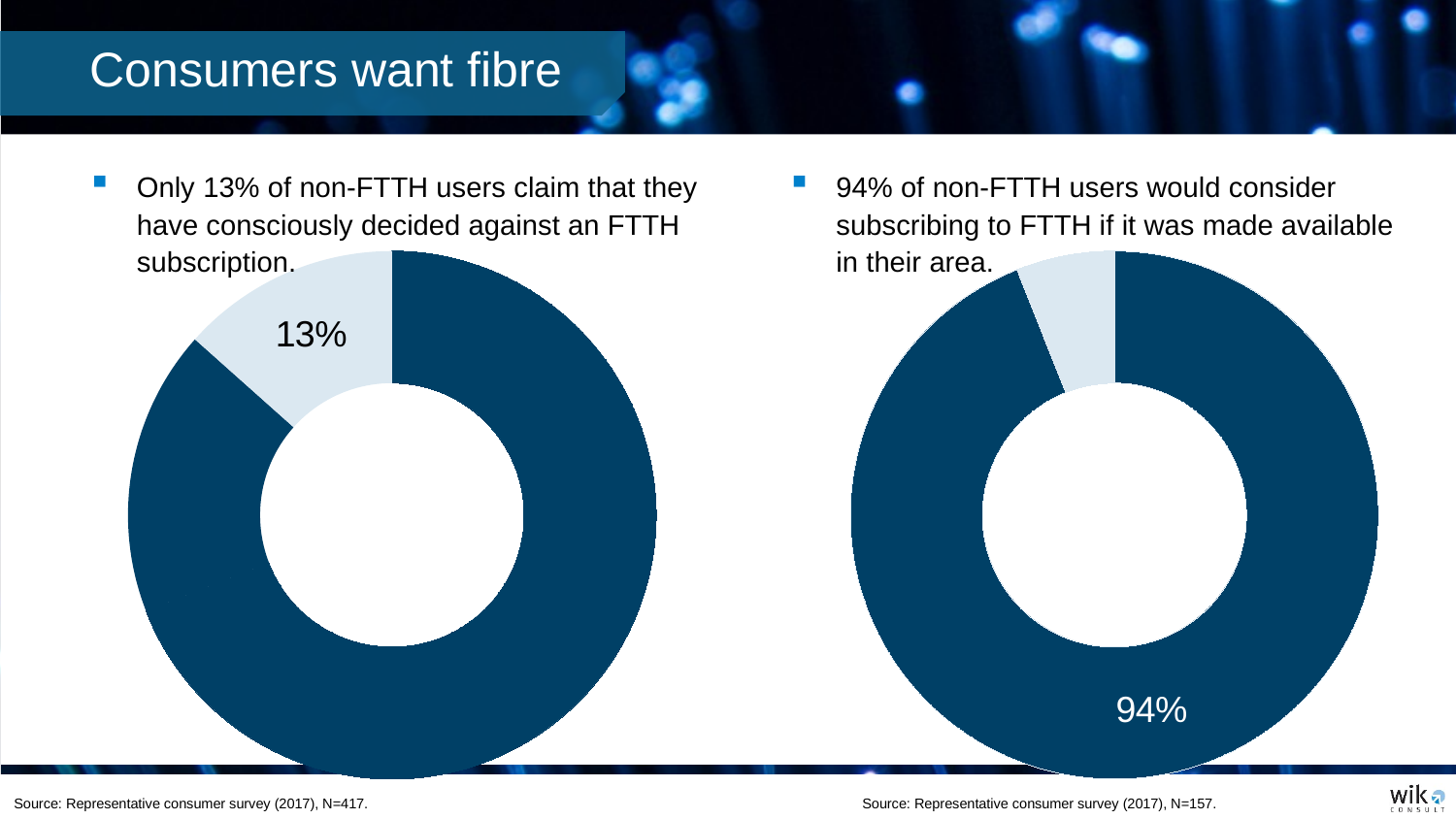
In the right chart, which slice is smaller, the dark one or the light one? The light one How many slices does the right donut chart have? 2 In the left chart, which slice is larger, the dark one or the light one? The dark one What kind of chart is shown on the left side of the slide? Donut (pie) chart Which is larger: the labelled value in the left chart (13%) or the labelled value in the right chart (94%)? The right chart's 94% What kind of chart is shown on the right side of the slide? Donut (pie) chart What is the sample size (N) given in the source note for the left chart? N=417 In the left chart, what percentage is printed on the light-coloured slice? 13% In the right chart, what percentage is printed on the dark-coloured slice? 94% In the left chart, what share of non-FTTH users consciously decided against an FTTH subscription? 13% In the right chart, what share of non-FTTH users would consider subscribing to FTTH if it was made available in their area? 94%